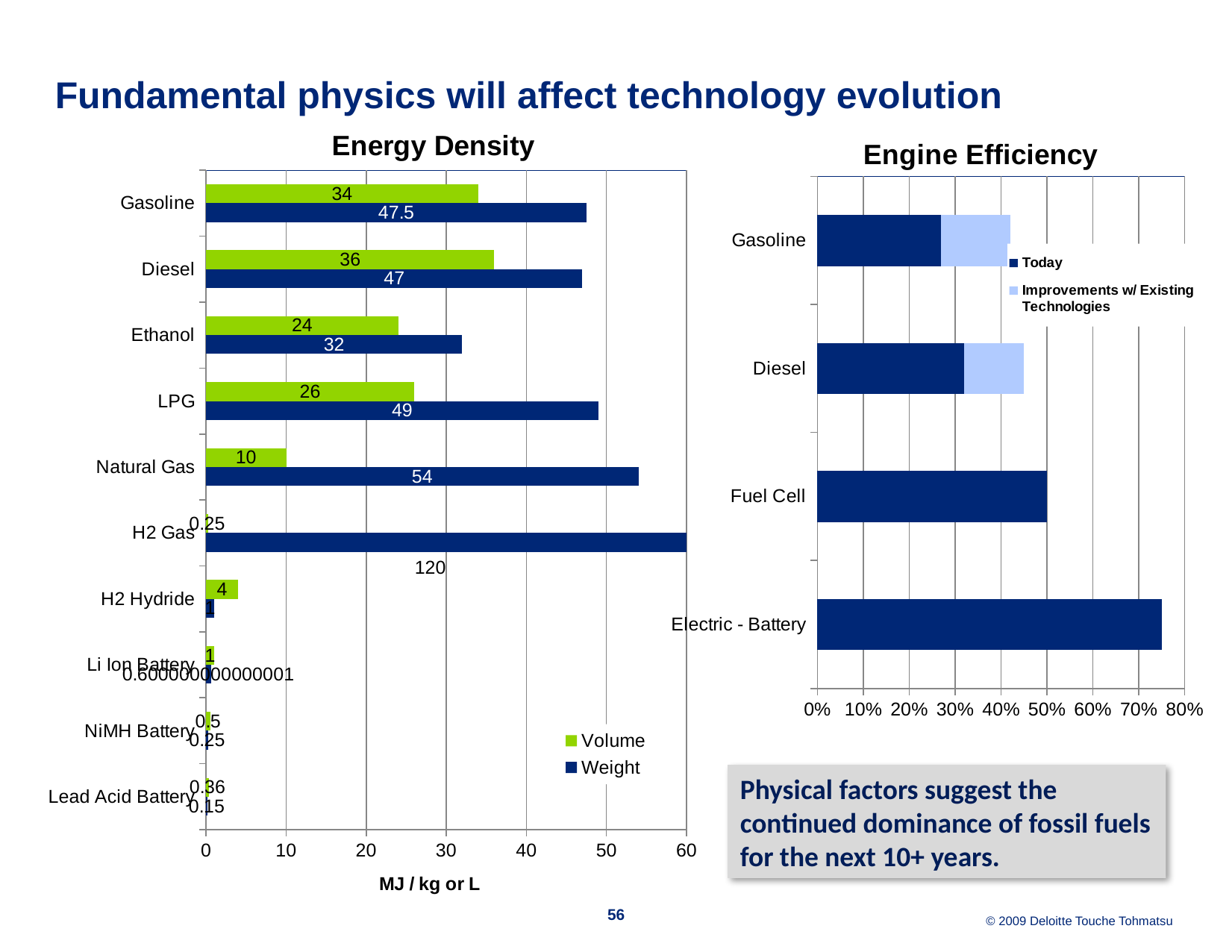
How many series does the legend of the Energy Density chart list? 2 In the Energy Density chart, what is the Volume value for Diesel? 36 How many categories are shown in the Energy Density chart? 10 In the Energy Density chart, what is the difference between the Weight and Volume values for Gasoline? 13.5 In the Energy Density chart, which category has the highest Weight value? H2 Gas In the Engine Efficiency chart, which category has the highest efficiency? Electric - Battery What kind of chart is the Energy Density chart? Bar chart What is the x-axis title of the Energy Density chart? MJ / kg or L In the Energy Density chart, what is the Weight value for Natural Gas? 54 In the Energy Density chart, which has the larger Volume value, Ethanol or LPG? LPG In the Engine Efficiency chart, is the value for Electric - Battery greater or less than 60%? greater How many categories are shown in the Engine Efficiency chart? 4